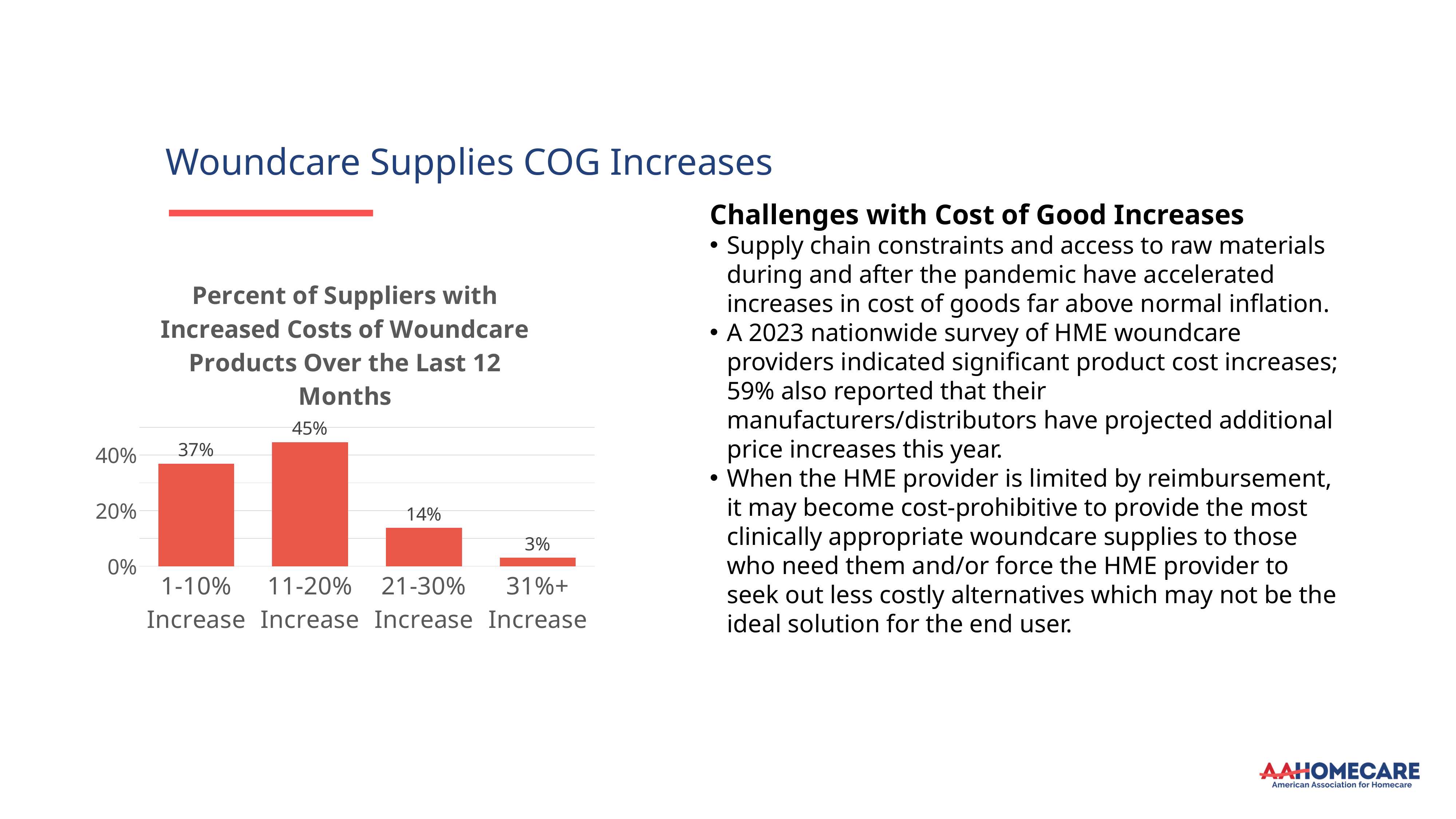
What kind of chart is shown on the slide? Bar chart What percent of suppliers reported a 21-30% increase? 14% What percent of suppliers reported a 1-10% increase in woundcare product costs? 37% Which is larger: the percent of suppliers with a 21-30% increase or with a 31%+ increase? 21-30% Increase What is the difference between the percent of suppliers in the 11-20% Increase category and the 1-10% Increase category? 8% Is the value for the 21-30% Increase category greater or less than 20%? less What percent of suppliers reported an 11-20% increase? 45% What percent of suppliers reported a 31%+ increase? 3% Which cost increase category has the highest percent of suppliers? 11-20% Increase How many cost increase categories are shown in the chart? 4 Which cost increase category has the lowest percent of suppliers? 31%+ Increase What is the title of the chart? Percent of Suppliers with Increased Costs of Woundcare Products Over the Last 12 Months